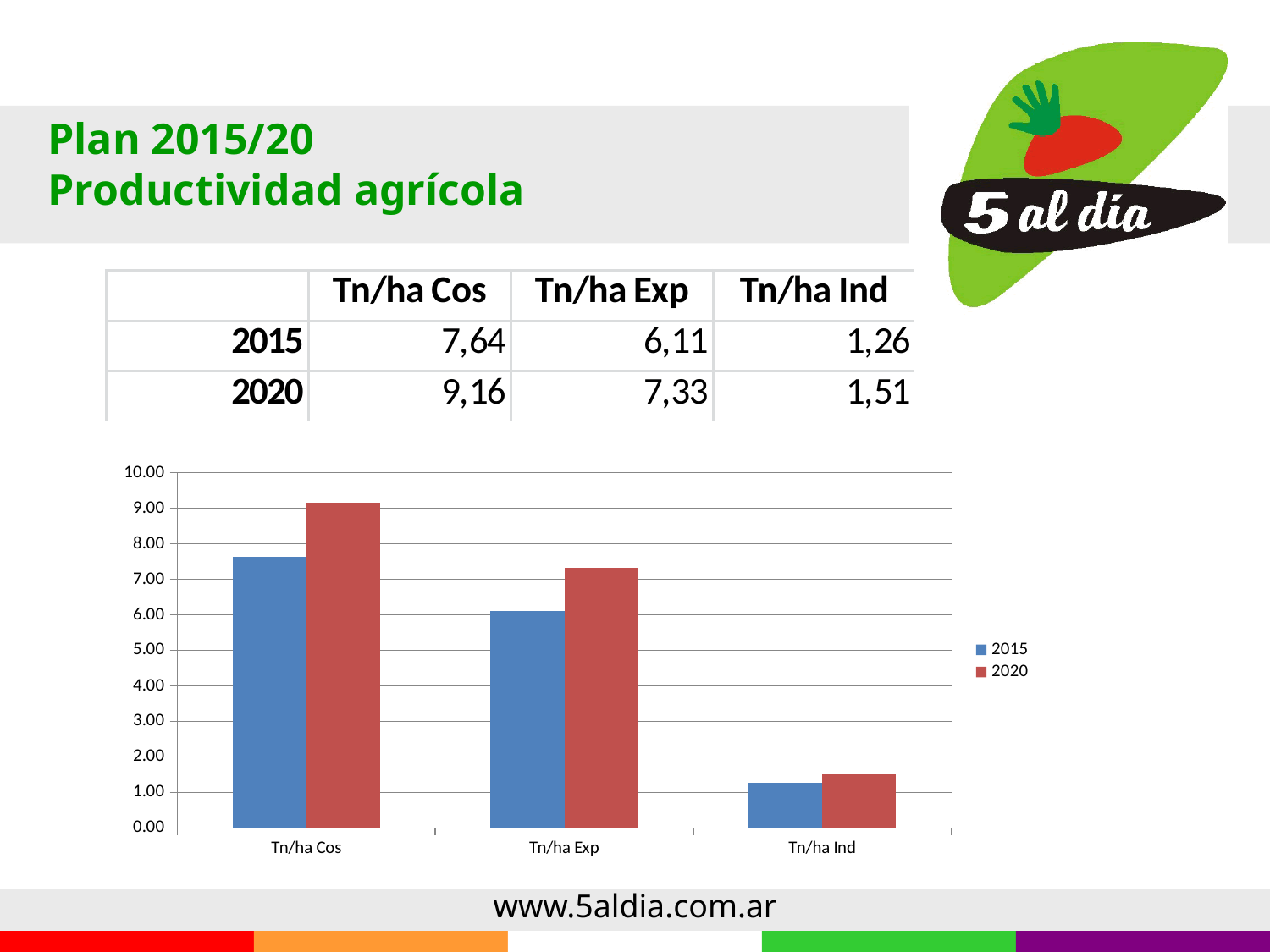
Which category has the lowest value for the 2015 series? Tn/ha Ind What kind of chart is shown on the slide? bar chart How many series does the chart legend list? 2 Which colour represents the 2020 series in the chart? red Is the 2020 value for Tn/ha Cos greater or less than 9.00? greater What is the difference between the 2020 and 2015 values for Tn/ha Cos? 1,52 What is the value for Tn/ha Ind in 2015? 1,26 Which is larger for Tn/ha Exp, the 2015 value or the 2020 value? 2020 What is the value for Tn/ha Exp in 2020? 7,33 Which category has the highest value for the 2020 series? Tn/ha Cos What is the value for Tn/ha Cos in 2015? 7,64 How many categories are shown on the x axis of the chart? 3